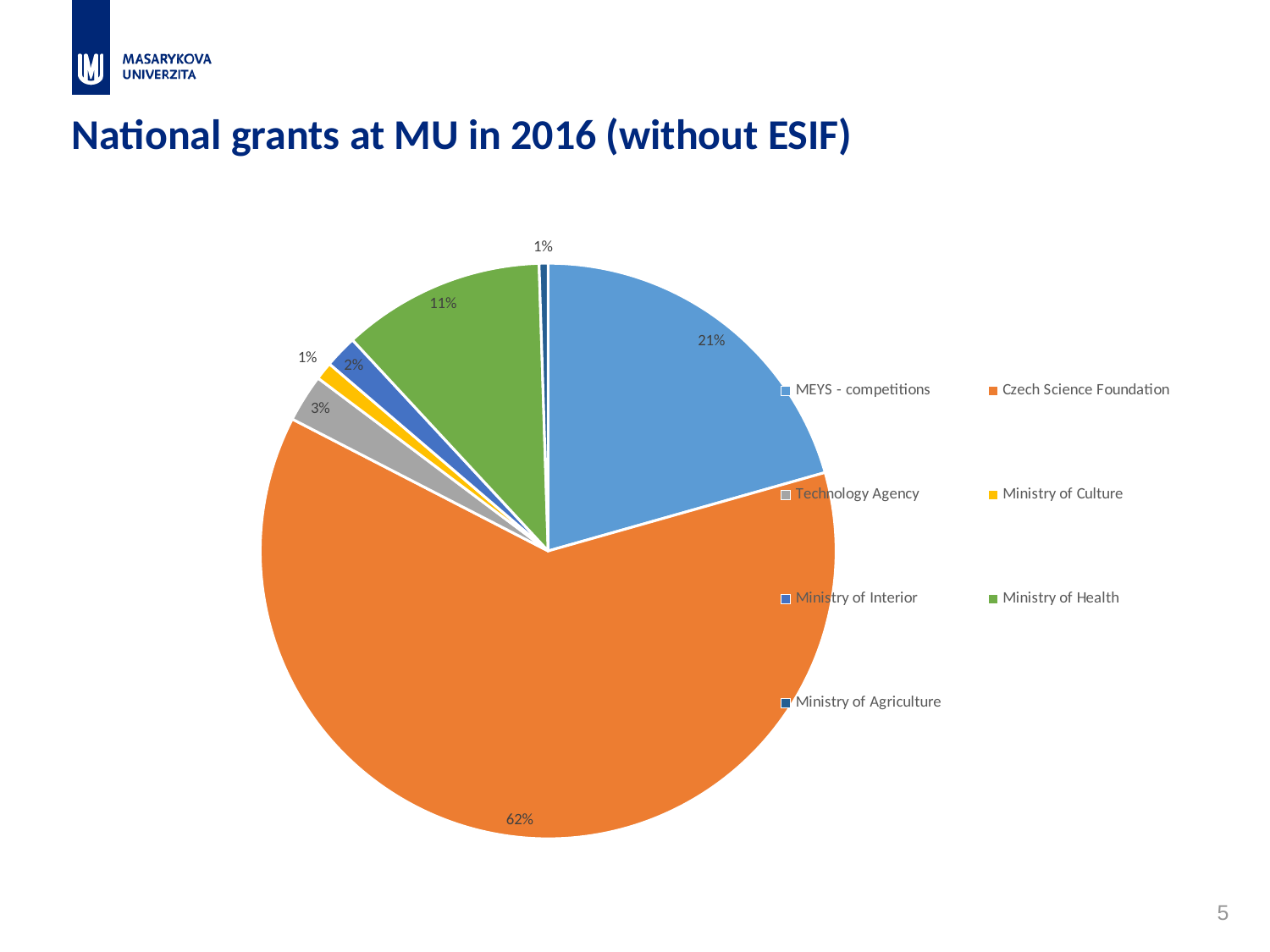
Which has a larger share, the Ministry of Health or the Technology Agency? Ministry of Health What is the difference in percentage points between the Czech Science Foundation and MEYS - competitions? 41 What colour is the slice for the Ministry of Culture? Yellow What is the title of the slide containing the chart? National grants at MU in 2016 (without ESIF) What share does the Ministry of Health hold? 11% What percentage is shown for the Ministry of Interior? 2% What type of chart is shown on the slide? Pie chart What percentage of the pie is MEYS - competitions? 21% How many funding sources does the legend list? 7 What share of national grants does the Czech Science Foundation account for? 62% What is the percentage shown for the Technology Agency? 3% Which funding source has the largest share of national grants? Czech Science Foundation